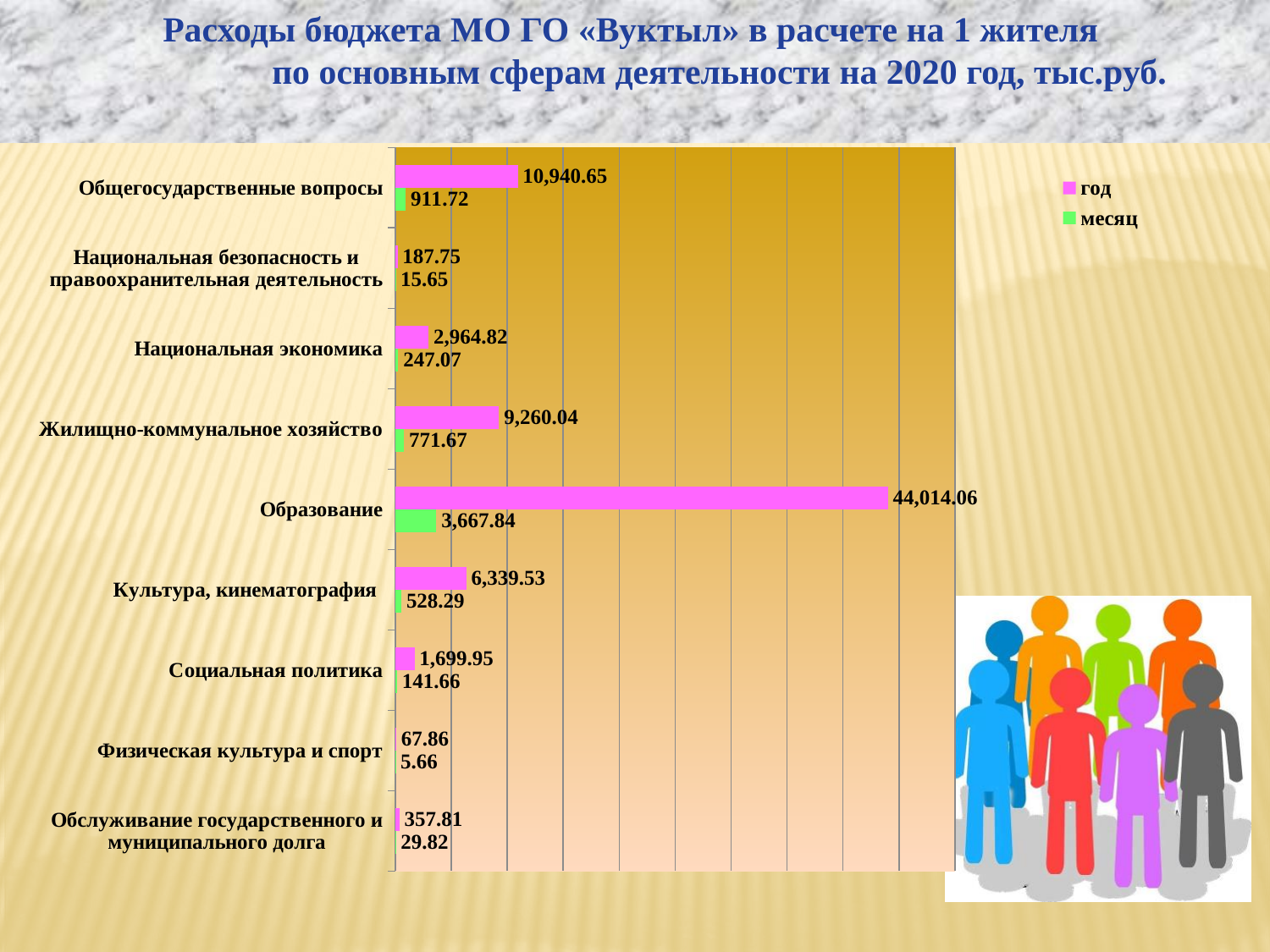
Which has the larger "год" value: Культура, кинематография or Жилищно-коммунальное хозяйство? Жилищно-коммунальное хозяйство What is the "месяц" value for Социальная политика? 141.66 How many categories are shown on the chart? 9 Which category has the lowest "год" value? Физическая культура и спорт What is the "год" value for Жилищно-коммунальное хозяйство? 9,260.04 What is the difference between the "год" and "месяц" values for Общегосударственные вопросы? 10,028.93 What is the value of the "месяц" series for Образование? 3,667.84 Which category has the highest "год" value? Образование How many series does the legend list? 2 What kind of chart is shown on the slide? Bar chart What is the difference between the "год" values for Национальная экономика and Национальная безопасность и правоохранительная деятельность? 2,777.07 What is the value of the "год" series for Образование? 44,014.06